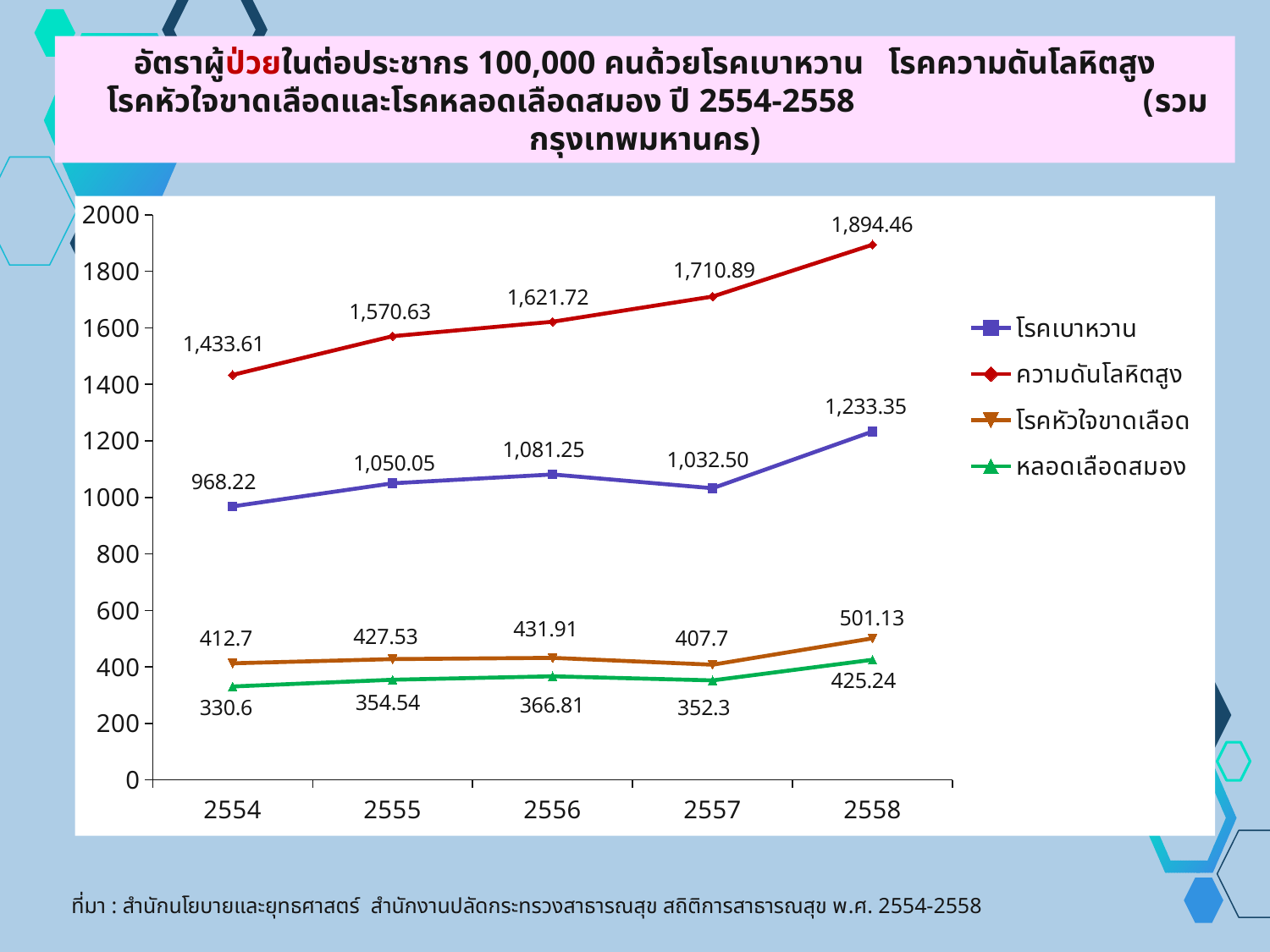
Which is larger in 2557: the value for โรคเบาหวาน or the value for โรคหัวใจขาดเลือด? โรคเบาหวาน What is the value for ความดันโลหิตสูง in 2558? 1,894.46 Does the value for ความดันโลหิตสูง rise or fall from 2554 to 2558? rise What is the value for หลอดเลือดสมอง in 2556? 366.81 How many series does the legend list? 4 What is the difference between the ความดันโลหิตสูง values in 2558 and 2554? 460.85 What is the value for โรคเบาหวาน in 2554? 968.22 What is the value for โรคหัวใจขาดเลือด in 2557? 407.7 What type of chart is shown on the slide? line chart How many years are shown on the x axis? 5 In which year is the value for ความดันโลหิตสูง highest? 2558 In which year is the value for หลอดเลือดสมอง lowest? 2554